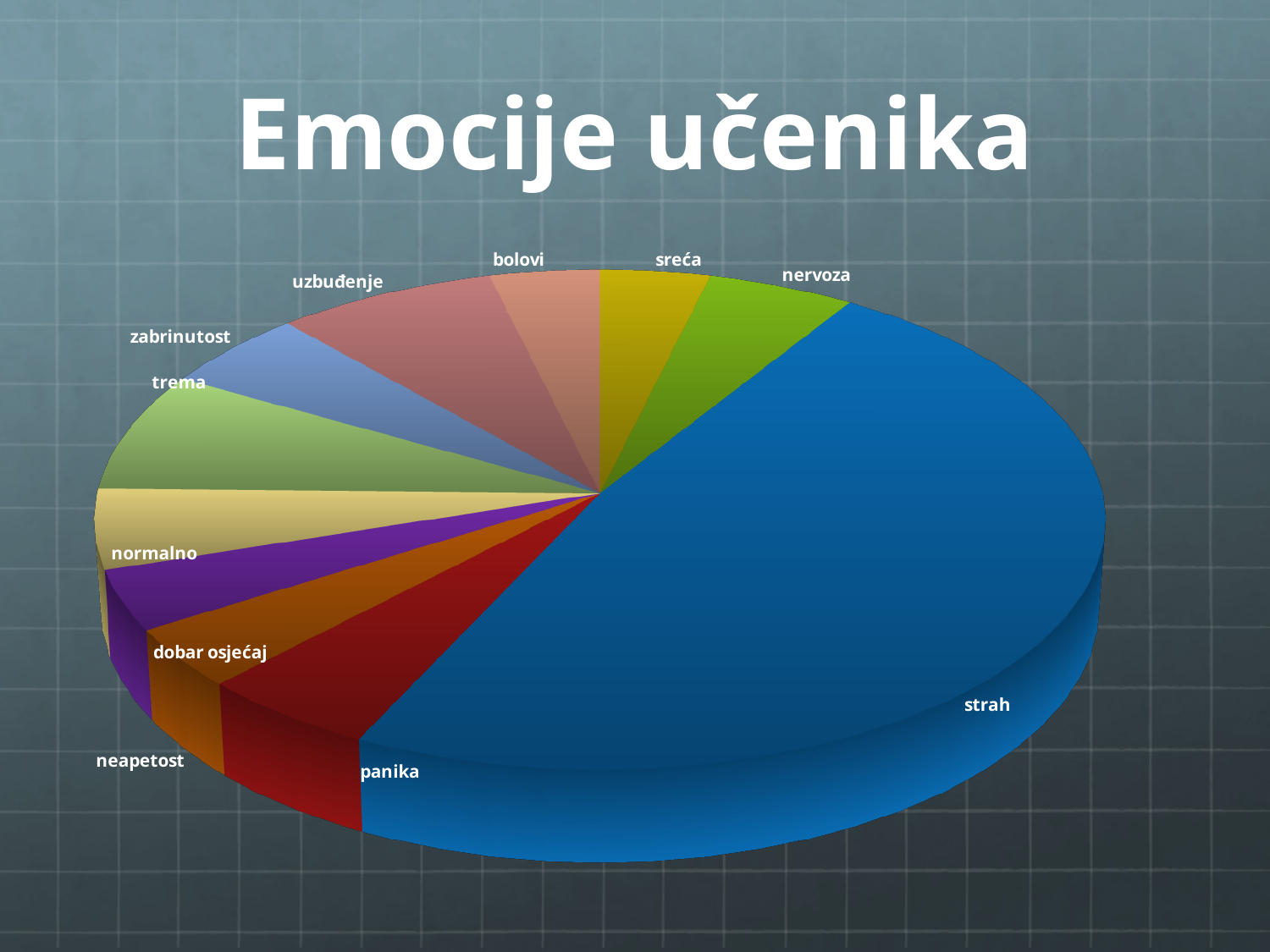
Which slice is larger, uzbuđenje or zabrinutost? uzbuđenje Which emotion has the largest slice of the pie? strah What is the title of the chart? Emocije učenika What kind of chart is shown on the slide? pie chart What colour is the slice for strah? blue How many slices (categories) does the pie chart have? 11 Which slice is larger, trema or zabrinutost? trema Which slice is larger, strah or panika? strah